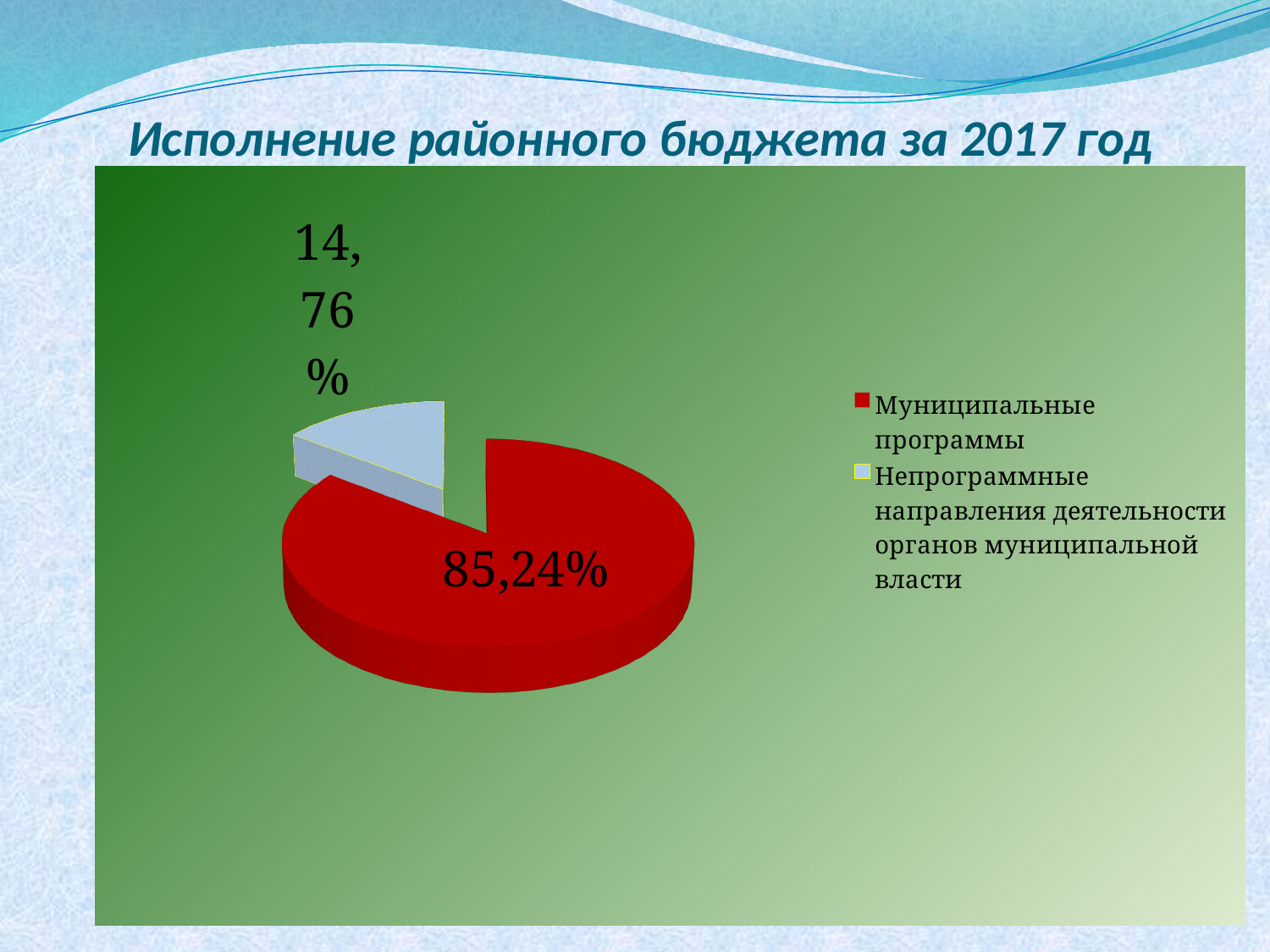
What kind of chart is shown on the slide? pie chart What is the title of the slide containing the chart? Исполнение районного бюджета за 2017 год Which slice of the pie is the largest? Муниципальные программы Which slice of the pie is the smallest? Непрограммные направления деятельности органов муниципальной власти What share of the pie does "Муниципальные программы" have? 85,24% What share of the pie does "Непрограммные направления деятельности органов муниципальной власти" have? 14,76% How many slices does the pie chart have? 2 How many entries does the legend list? 2 What is the difference in percentage points between the "Муниципальные программы" slice and the "Непрограммные направления деятельности органов муниципальной власти" slice? 70,48 What colour is the "Муниципальные программы" slice? red Which is larger: the share for "Муниципальные программы" or the share for "Непрограммные направления деятельности органов муниципальной власти"? Муниципальные программы